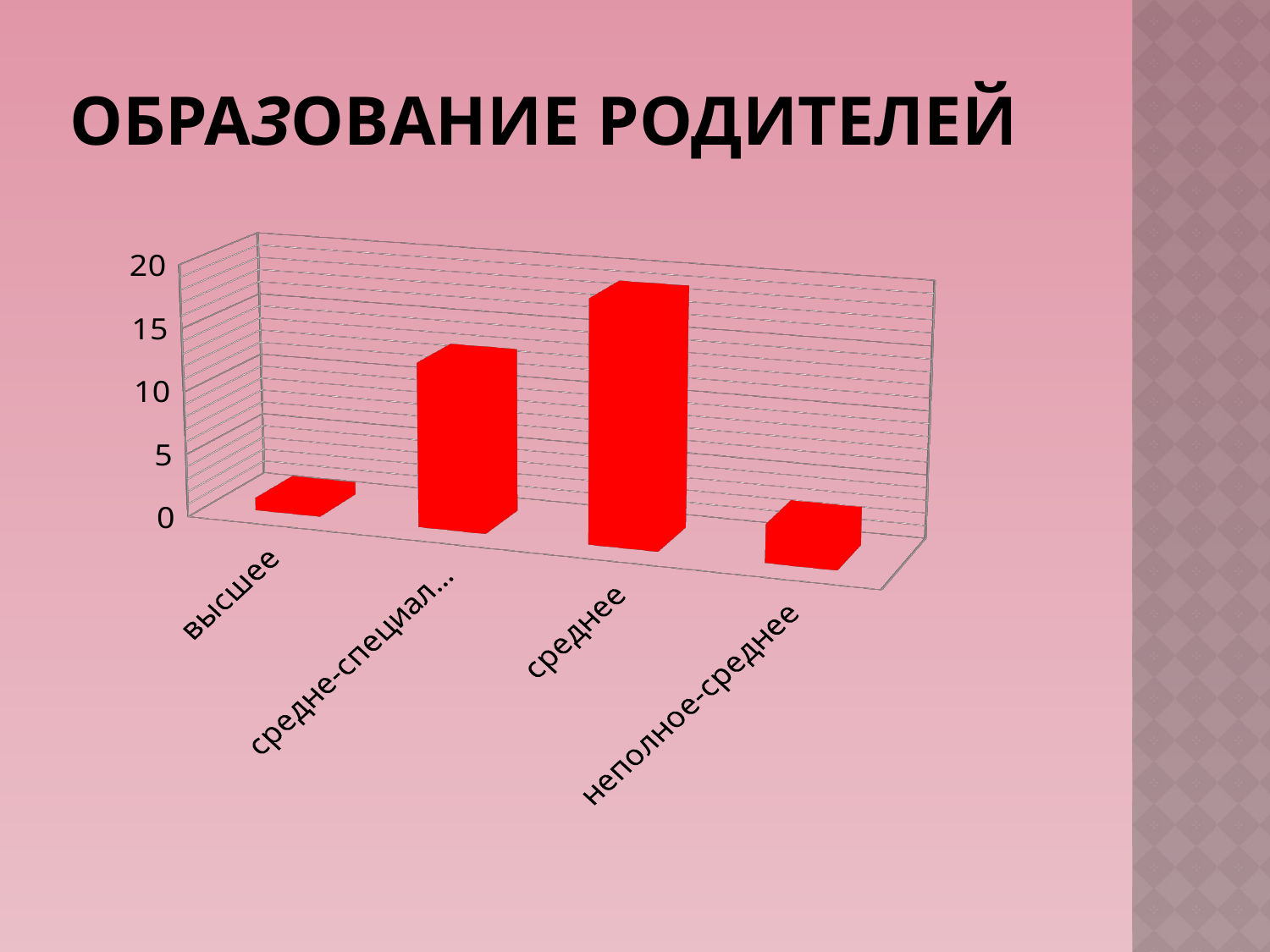
Is the value for среднее greater or less than 15? greater What is the highest value shown on the vertical axis of the chart? 20 What kind of chart is shown on the slide? bar chart Is the value for неполное-среднее greater or less than 5? less Which category has the highest bar in the chart? среднее Which is larger, the value for среднее or the value for средне-специал...? среднее How many categories are shown on the x axis of the chart? 4 Which is larger, the value for высшее or the value for среднее? среднее What colour are the bars in the chart? red Is the value for высшее greater or less than 5? less What is the title of the slide with the chart? ОБРАЗОВАНИЕ РОДИТЕЛЕЙ